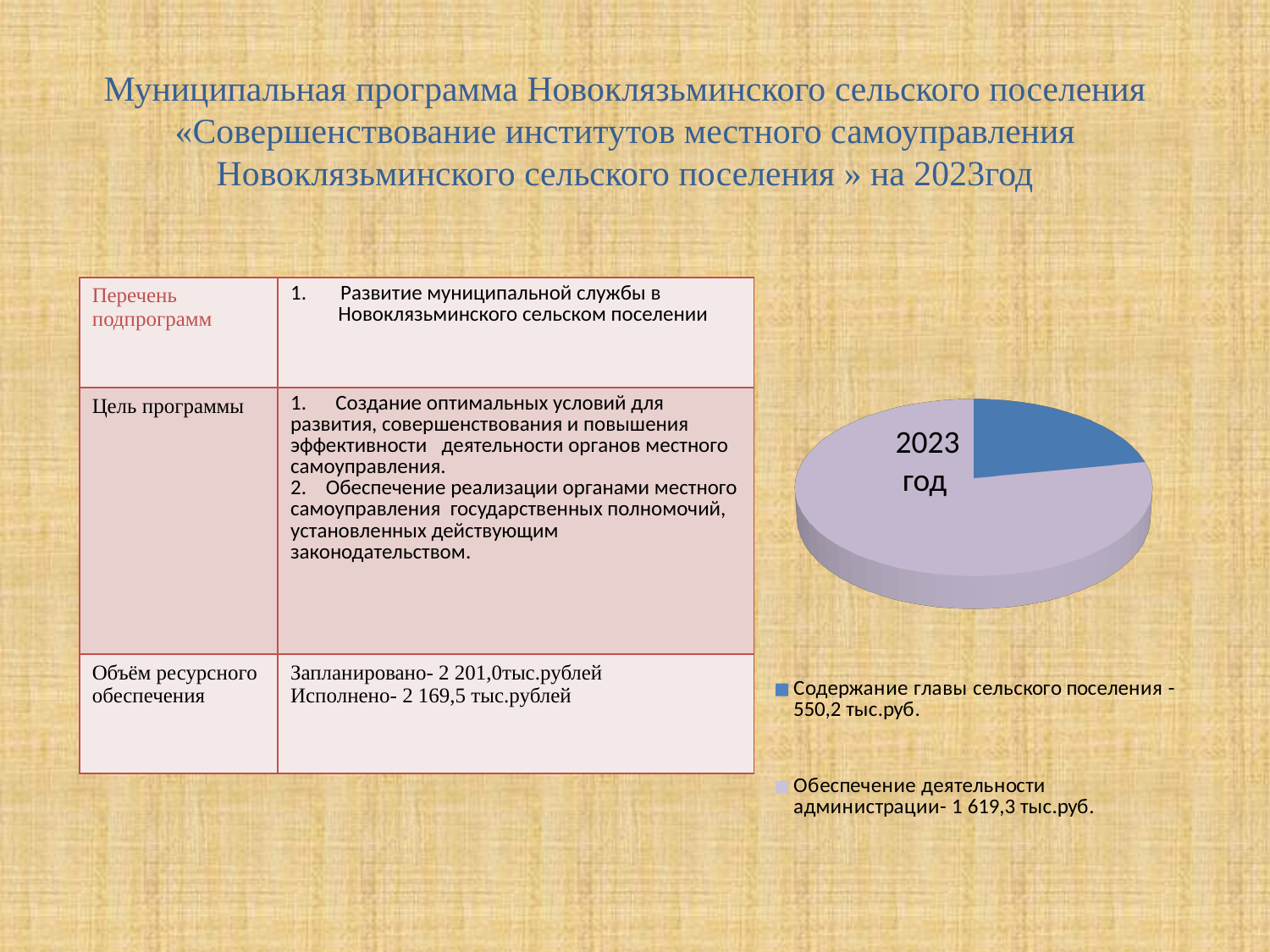
What is the value for "Содержание главы сельского поселения" in the pie chart? 550,2 тыс.руб. What title is shown on the pie chart? 2023 год What kind of chart is shown on the slide? Pie chart What is the difference between "Обеспечение деятельности администрации" and "Содержание главы сельского поселения" in the pie chart? 1 069,1 тыс.руб. Which category has the smallest slice in the pie chart? Содержание главы сельского поселения How many slices does the pie chart have? 2 What is the value for "Обеспечение деятельности администрации" in the pie chart? 1 619,3 тыс.руб. What is the total of the two values shown in the pie chart legend? 2 169,5 тыс.руб. Which is larger: "Содержание главы сельского поселения" or "Обеспечение деятельности администрации"? Обеспечение деятельности администрации What colour is the slice for "Содержание главы сельского поселения" in the pie chart? Blue How many entries does the legend of the pie chart list? 2 Which category has the largest slice in the pie chart? Обеспечение деятельности администрации